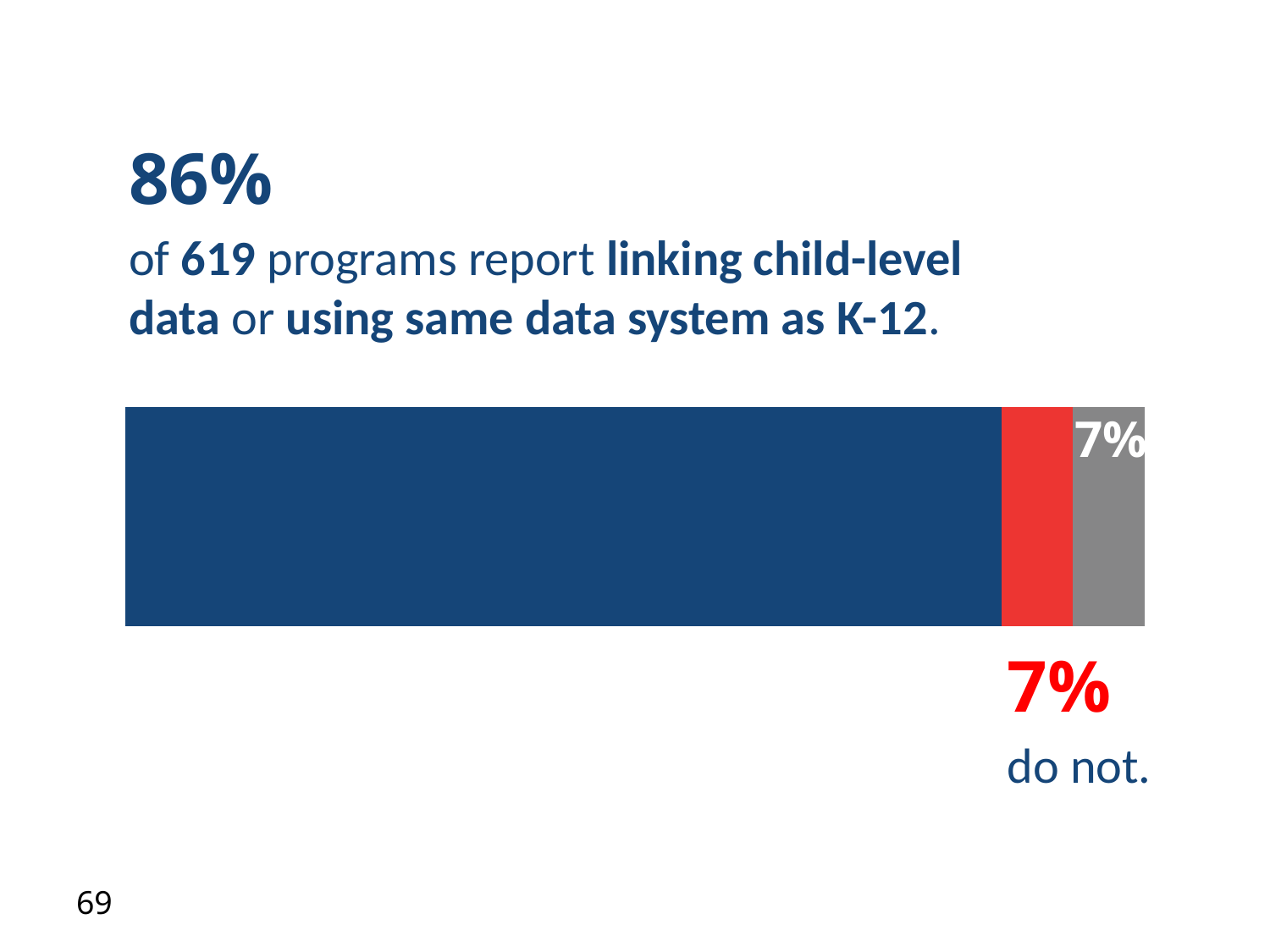
Which colour segment of the bar is the largest? blue Is the blue segment or the red segment of the bar larger? blue What colour is the segment labelled 'do not' on the slide? red How many segments make up the stacked bar on the slide? 3 What is the total of the three segments of the stacked bar (86%, 7% and 7%)? 100% What percentage of programs do not link child-level data or use the same data system as K-12? 7% What kind of chart is shown on the slide? bar chart What percentage of the 619 programs report linking child-level data or using the same data system as K-12? 86% How many programs does the slide say were surveyed? 619 What value is printed on the gray segment of the bar? 7% What is the difference between the 86% segment and the 7% 'do not' segment? 79%